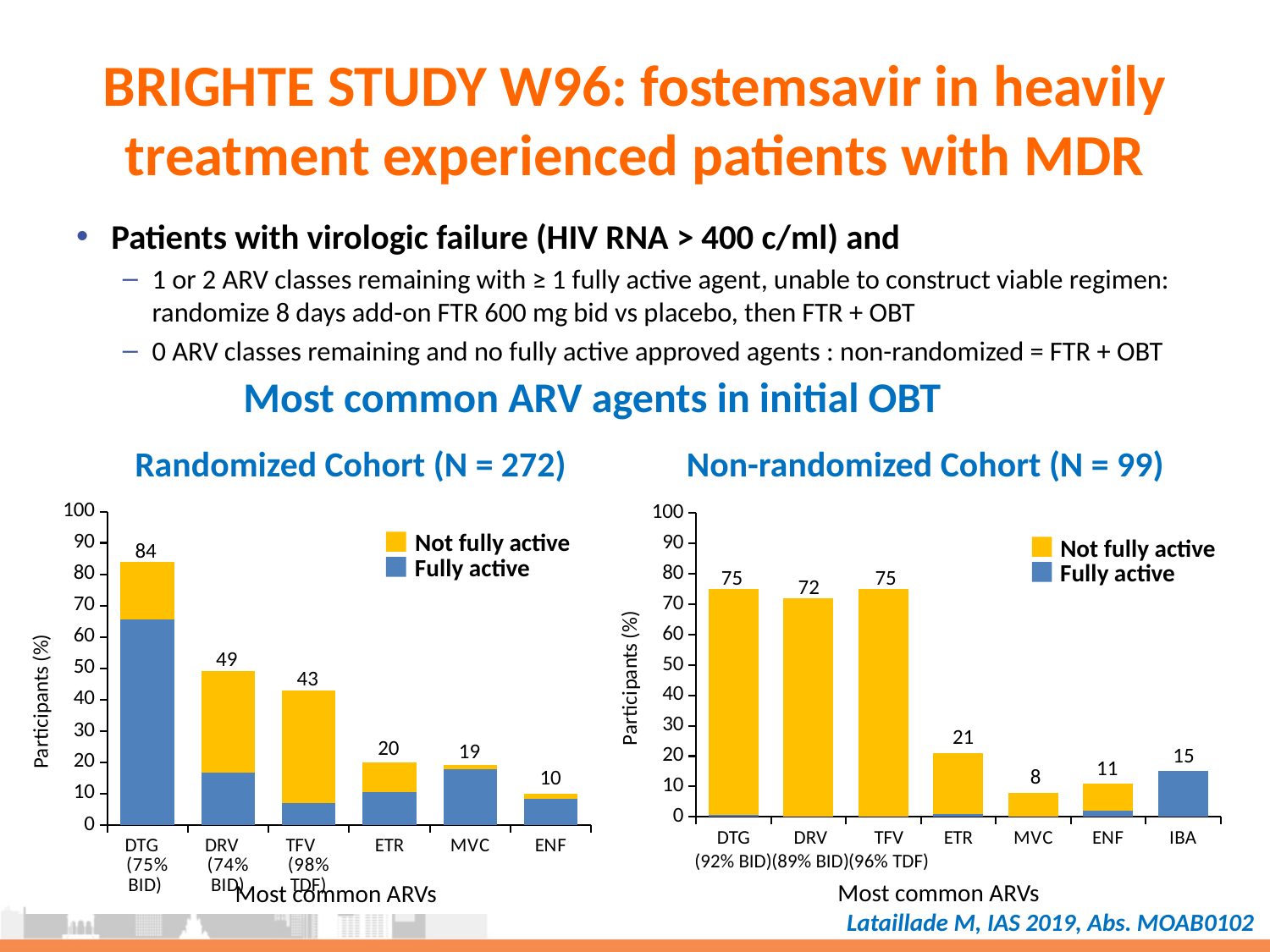
In the Randomized Cohort (N = 272) chart, which ARV agent has the lowest total value? ENF In the Non-randomized Cohort (N = 99) chart, what is the difference between the total values for ETR and IBA? 6 In the Randomized Cohort (N = 272) chart, what is the difference between the total values for DRV and TFV? 6 In the Randomized Cohort (N = 272) chart, what is the total percentage of participants for DTG? 84 In the Randomized Cohort (N = 272) chart, is the fully active portion of the DTG bar greater or less than 60? greater In the Non-randomized Cohort (N = 99) chart, which ARV agent has the lowest total value? MVC What type of chart is the Non-randomized Cohort (N = 99) chart? Stacked bar chart In the Non-randomized Cohort (N = 99) chart, how many ARV agents are shown on the x axis? 7 In the Randomized Cohort (N = 272) chart, how many ARV agents are shown on the x axis? 6 In the Non-randomized Cohort (N = 99) chart, what is the total value for DRV? 72 How many series does the legend list in the Randomized Cohort (N = 272) chart? 2 In the Non-randomized Cohort (N = 99) chart, is the total for ENF larger or smaller than the total for IBA? smaller